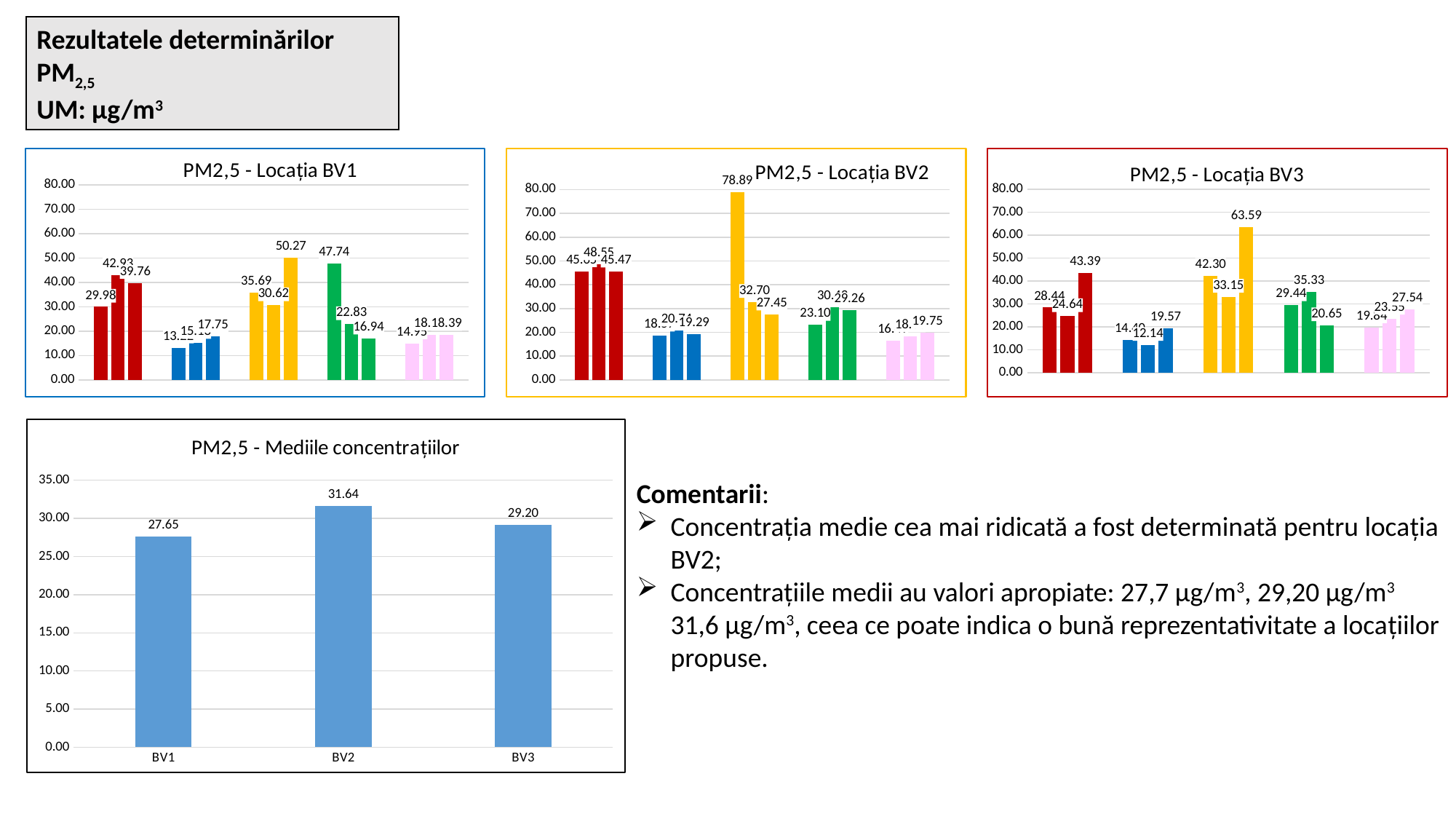
In the chart 'PM2,5 - Locația BV2', what is the highest value shown? 78.89 In the chart 'PM2,5 - Mediile concentrațiilor', what is the value for BV2? 31.64 In the chart 'PM2,5 - Locația BV3', what is the highest value shown? 63.59 In the chart 'PM2,5 - Mediile concentrațiilor', what is the value for BV1? 27.65 What kind of chart is 'PM2,5 - Mediile concentrațiilor'? bar chart In the chart 'PM2,5 - Mediile concentrațiilor', which location has the highest value? BV2 In the chart 'PM2,5 - Mediile concentrațiilor', which is larger, the value for BV3 or the value for BV1? BV3 In the chart 'PM2,5 - Mediile concentrațiilor', which location has the lowest value? BV1 In the chart 'PM2,5 - Mediile concentrațiilor', what is the value for BV3? 29.20 How many charts are shown on the slide? 4 In the chart 'PM2,5 - Mediile concentrațiilor', what is the difference between the values for BV2 and BV1? 3.99 In the chart 'PM2,5 - Mediile concentrațiilor', how many locations are shown? 3